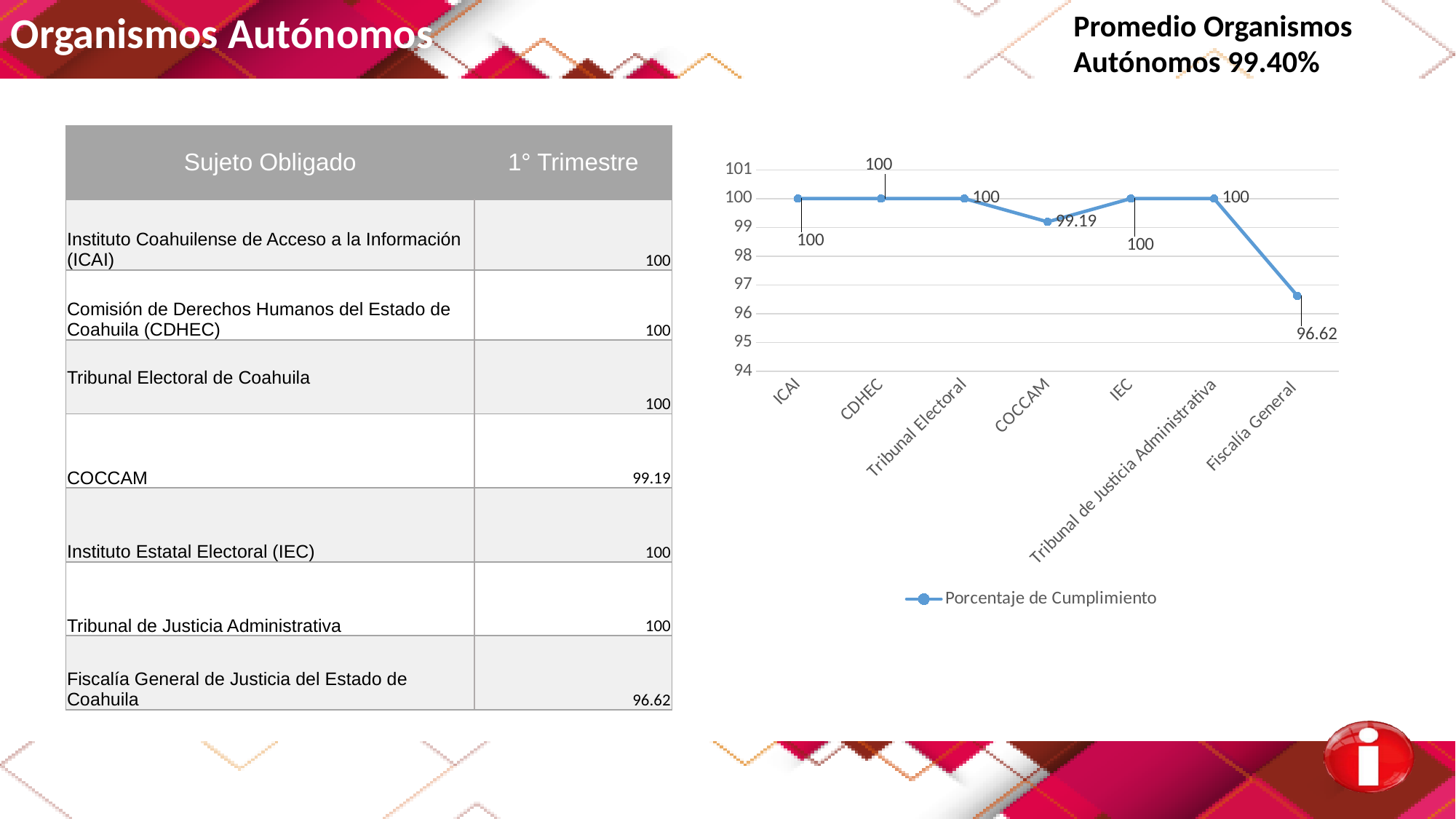
What is the value for COCCAM in the chart? 99.19 Which is larger, the value for COCCAM or the value for Fiscalía General? COCCAM What is the difference between the values for COCCAM and Fiscalía General? 2.57 Is the value for Fiscalía General greater or less than 97? less What is the value for ICAI in the chart? 100 What series name does the chart legend show? Porcentaje de Cumplimiento What is the value for Tribunal de Justicia Administrativa in the chart? 100 How many categories are plotted on the x axis of the chart? 7 Which category has the lowest value in the chart? Fiscalía General What is the difference between the values for IEC and COCCAM? 0.81 What kind of chart is shown on the slide? line chart What is the value for Fiscalía General in the chart? 96.62